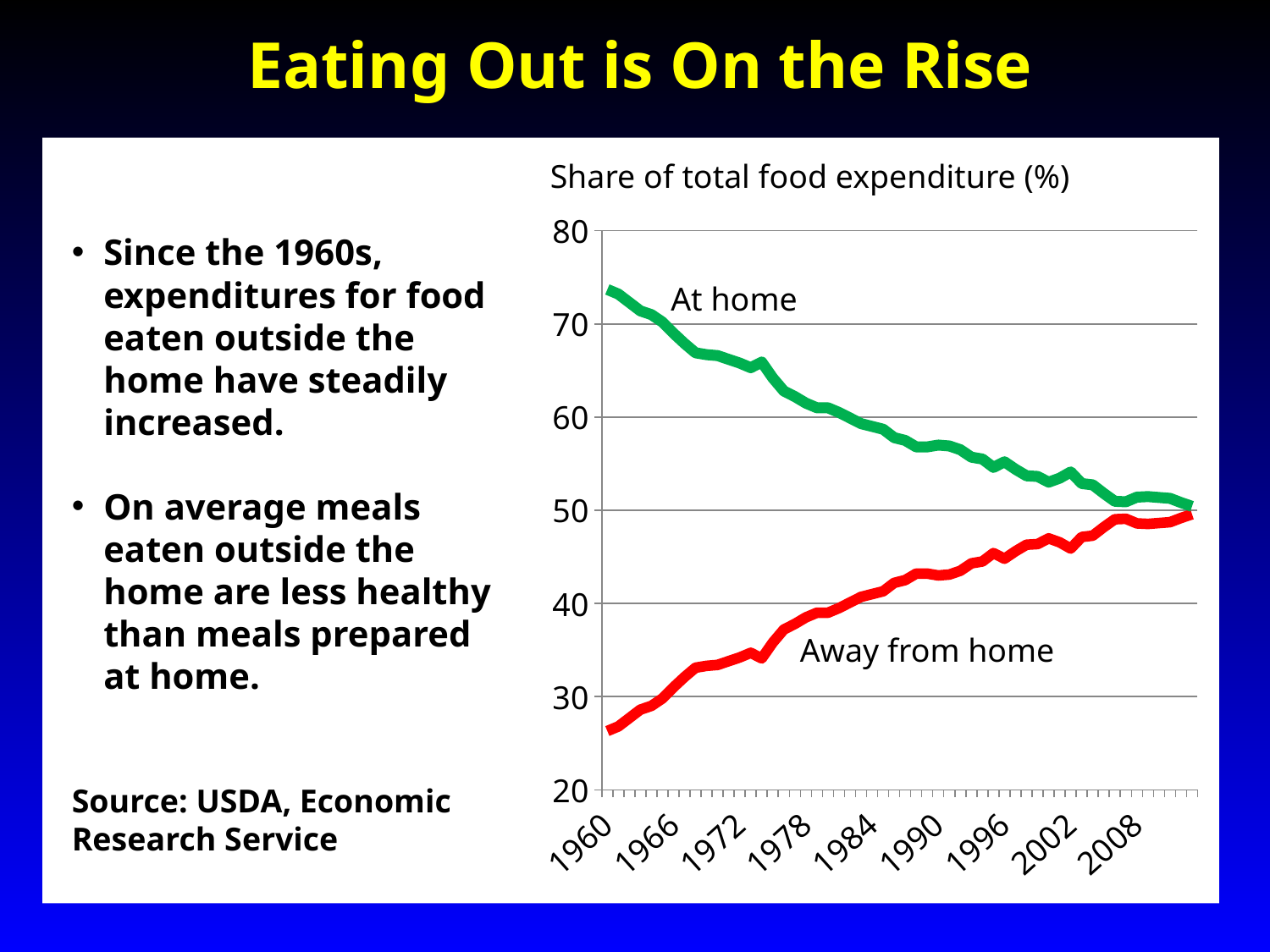
Is the 'Away from home' value in 1960 greater or less than 30? less Is the 'At home' value in 1996 greater or less than 60? less What colour is the 'At home' line? green What is the title of the chart? Share of total food expenditure (%) Is the 'Away from home' value in 1972 greater or less than 40? less What kind of chart is shown on the slide? line chart How many series are plotted on the chart? 2 In 1960, which series has the larger value, 'At home' or 'Away from home'? At home Does the 'At home' series rise or fall from 1960 to 2008? fall Does the 'Away from home' series rise or fall from 1960 to 2008? rise